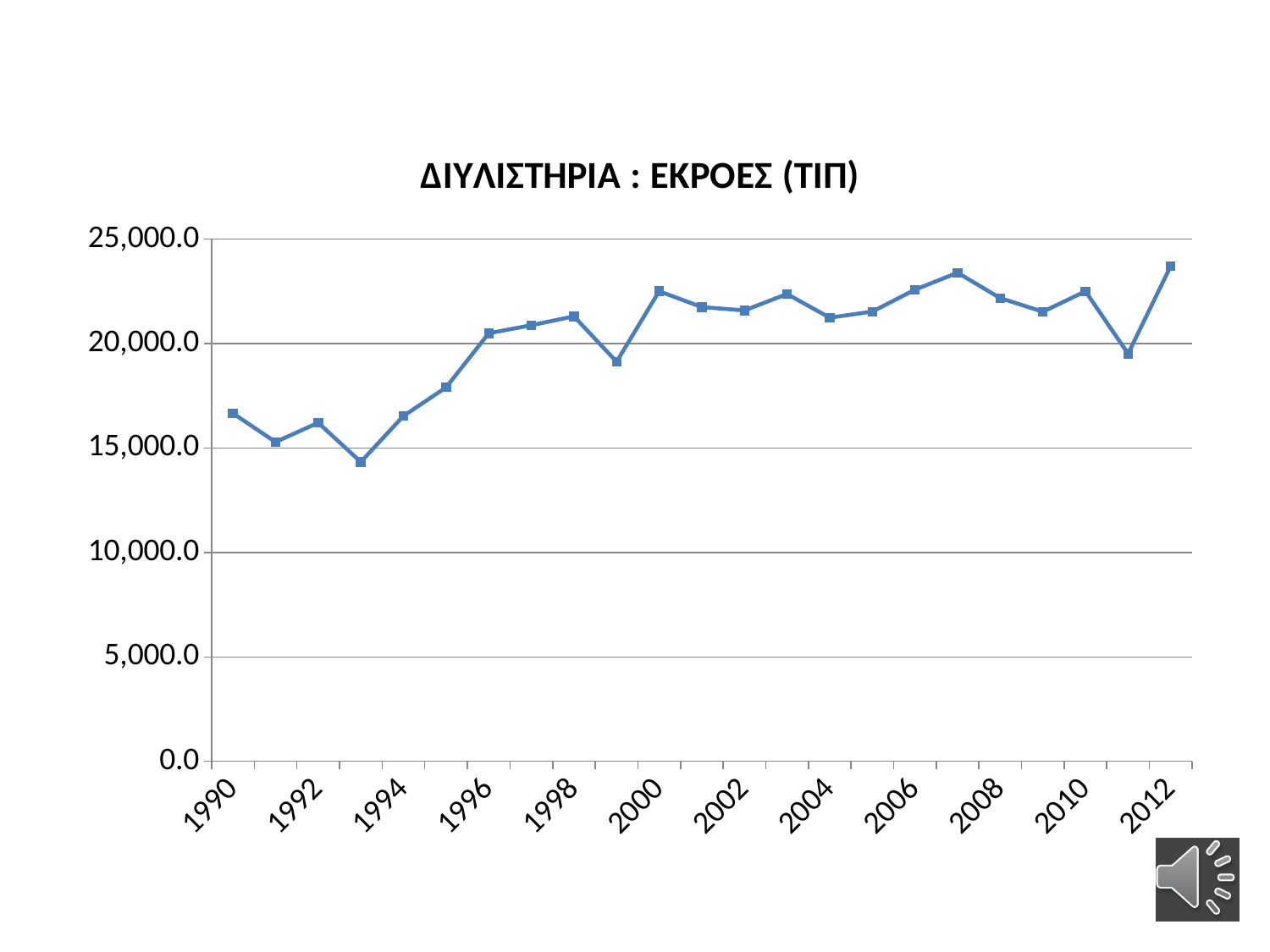
Do the values generally rise or fall from 1993 to 1998? rise Which is larger, the value for 1999 or the value for 2000? 2000 Which is larger, the value for 2010 or the value for 2011? 2010 What is the title of the chart? ΔΙΥΛΙΣΤΗΡΙΑ : ΕΚΡΟΕΣ (ΤΙΠ) Is the value for 1990 greater or less than 15,000.0? greater Which year has the lowest value on the chart? 1993 What is the first year shown on the x axis? 1990 What kind of chart is shown on the slide? line chart Is the value for 1993 greater or less than 15,000.0? less Is the value for 1999 greater or less than 20,000.0? less